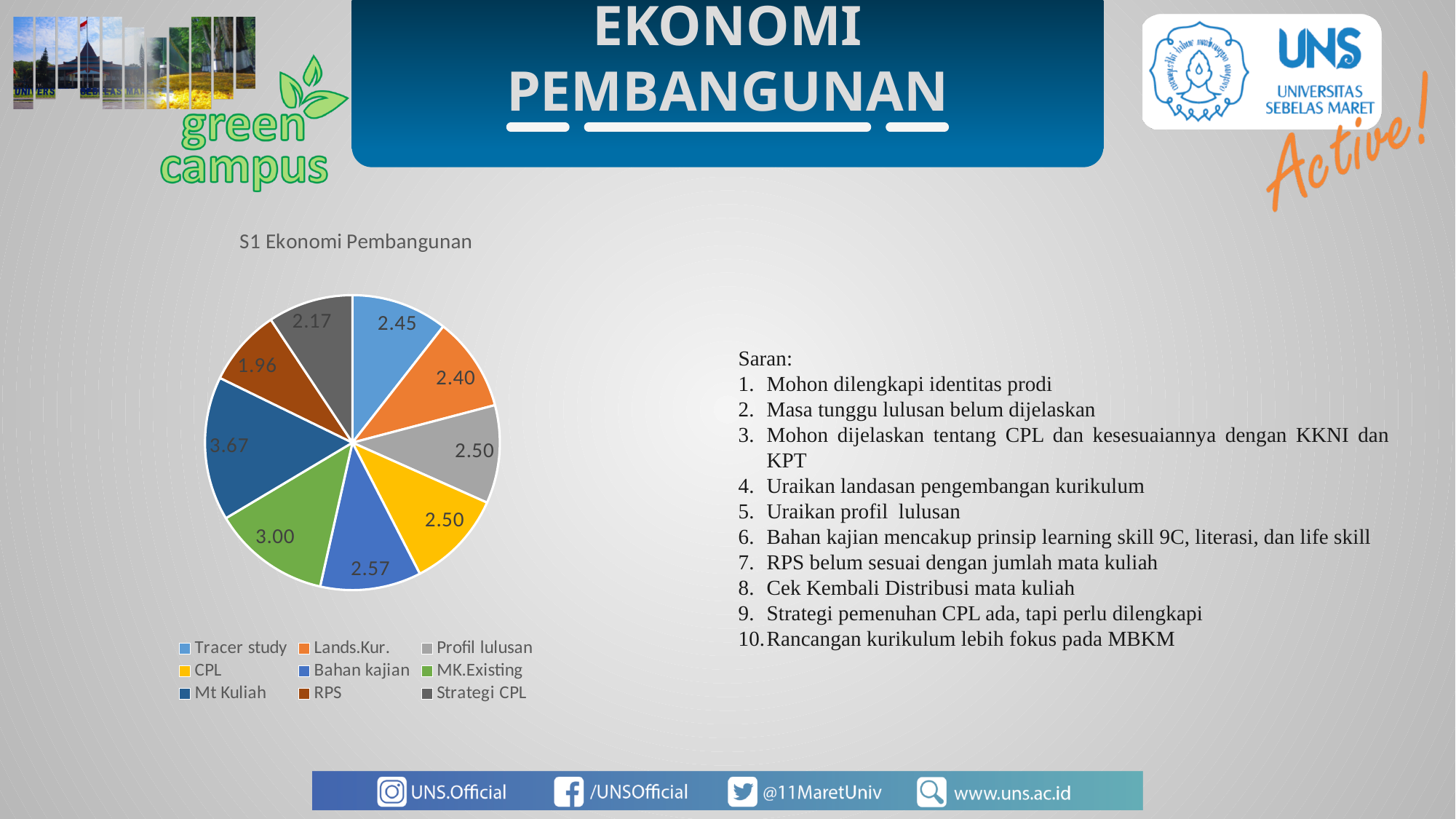
What type of chart is shown on the slide? pie chart What is the title of the chart? S1 Ekonomi Pembangunan What is the difference between the values for Mt Kuliah and RPS? 1.71 What is the value for Mt Kuliah in the pie chart? 3.67 How many categories does the pie chart have? 9 Which is larger, the value for Bahan kajian or the value for Lands.Kur.? Bahan kajian What is the value for RPS in the pie chart? 1.96 Which category has the smallest slice in the pie chart? RPS Which category has the largest slice in the pie chart? Mt Kuliah What is the value for Tracer study in the pie chart? 2.45 What colour is the Strategi CPL slice in the pie chart? dark gray What is the value for MK.Existing in the pie chart? 3.00